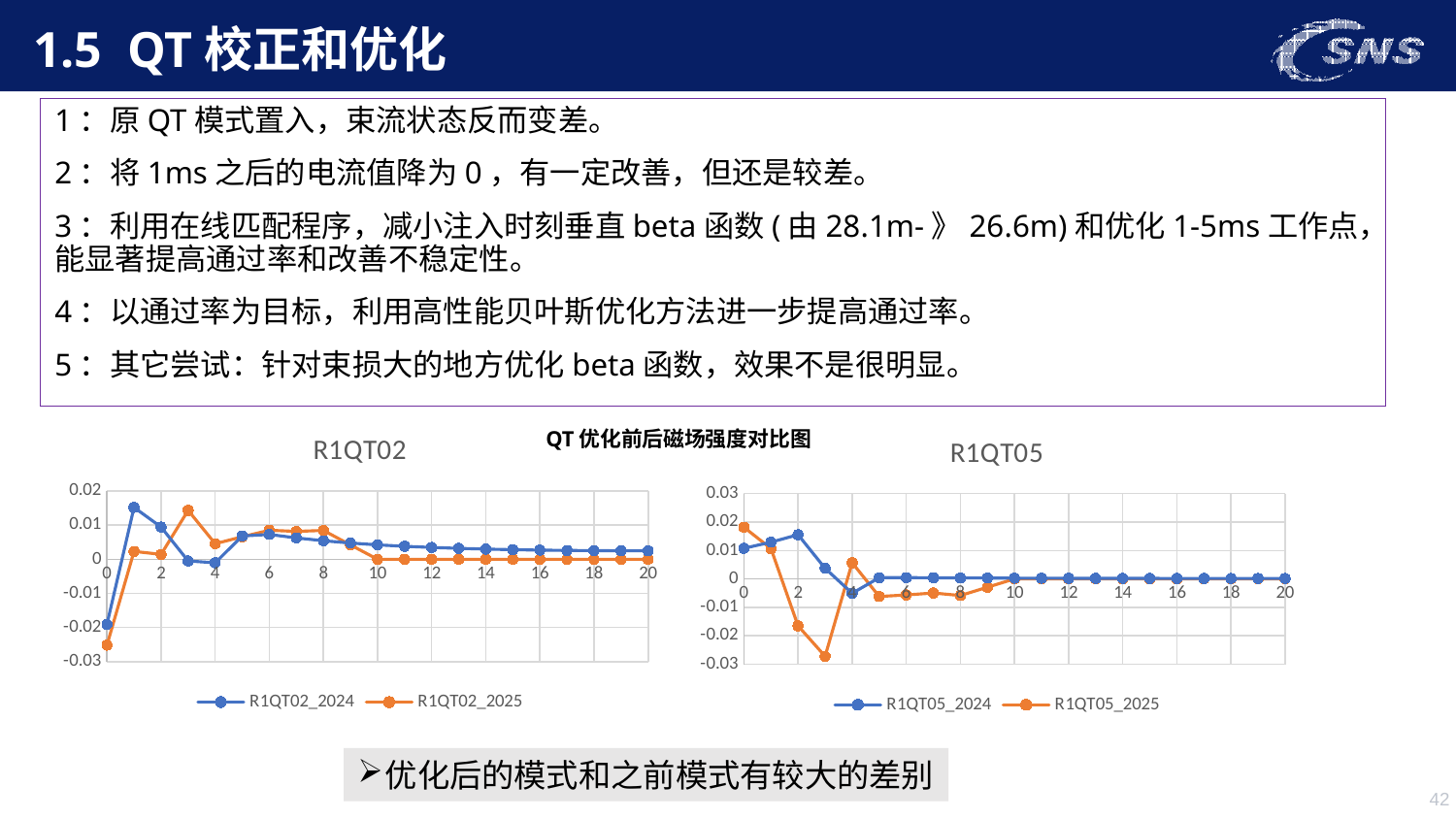
In the R1QT05 chart, at which x value does the R1QT05_2025 series reach its lowest point? 3 What are the two legend entries of the R1QT02 chart? R1QT02_2024 and R1QT02_2025 In the R1QT05 chart, is the value of R1QT05_2025 at x = 3 greater or less than -0.02? less In the R1QT02 chart, is the value of R1QT02_2024 at x = 0 greater or less than -0.01? less In the R1QT05 chart, at x = 3, which series has the larger value, R1QT05_2024 or R1QT05_2025? R1QT05_2024 What kind of chart is the R1QT02 chart? line chart In the R1QT02 chart, is the value of R1QT02_2024 at x = 1 greater or less than 0.01? greater How many series does the legend of the R1QT05 chart list? 2 What is the overall title shown between the two charts? QT 优化前后磁场强度对比图 In the R1QT05 chart, do the values of both series rise, fall, or stay roughly flat from x = 10 to x = 20? stay roughly flat